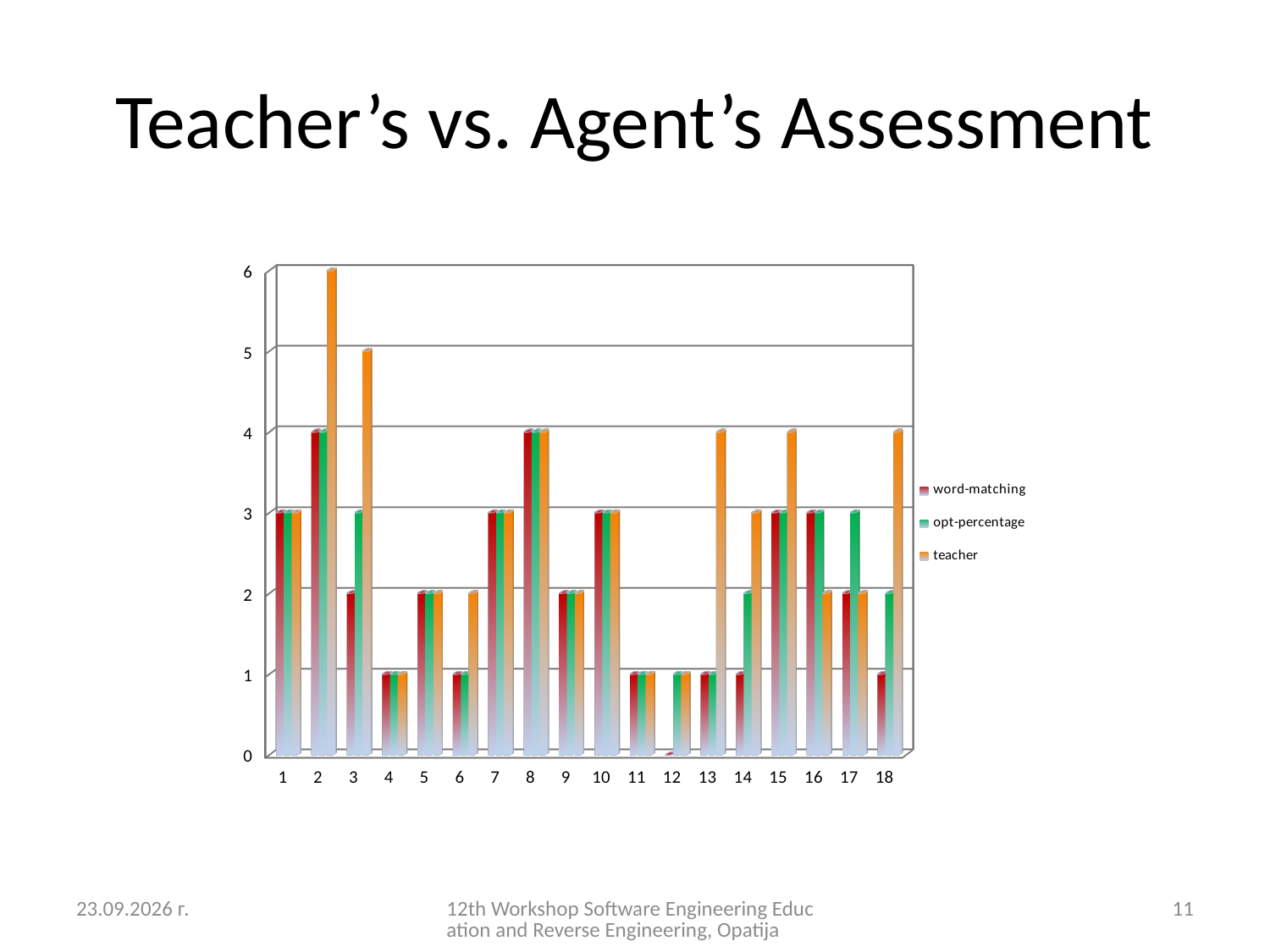
Is the teacher value for category 2 greater or less than 5? greater What is the teacher value for category 2? 6 What is the teacher value for category 3? 5 How many series does the legend list? 3 What is the opt-percentage value for category 17? 3 What kind of chart is shown on the slide? bar chart For category 14, which is larger: the teacher value or the word-matching value? teacher How many categories are shown along the x axis? 18 Which category has the highest teacher value? 2 What is the difference between the teacher value and the word-matching value for category 13? 3 What are the three series named in the legend? word-matching, opt-percentage, teacher What is the word-matching value for category 8? 4